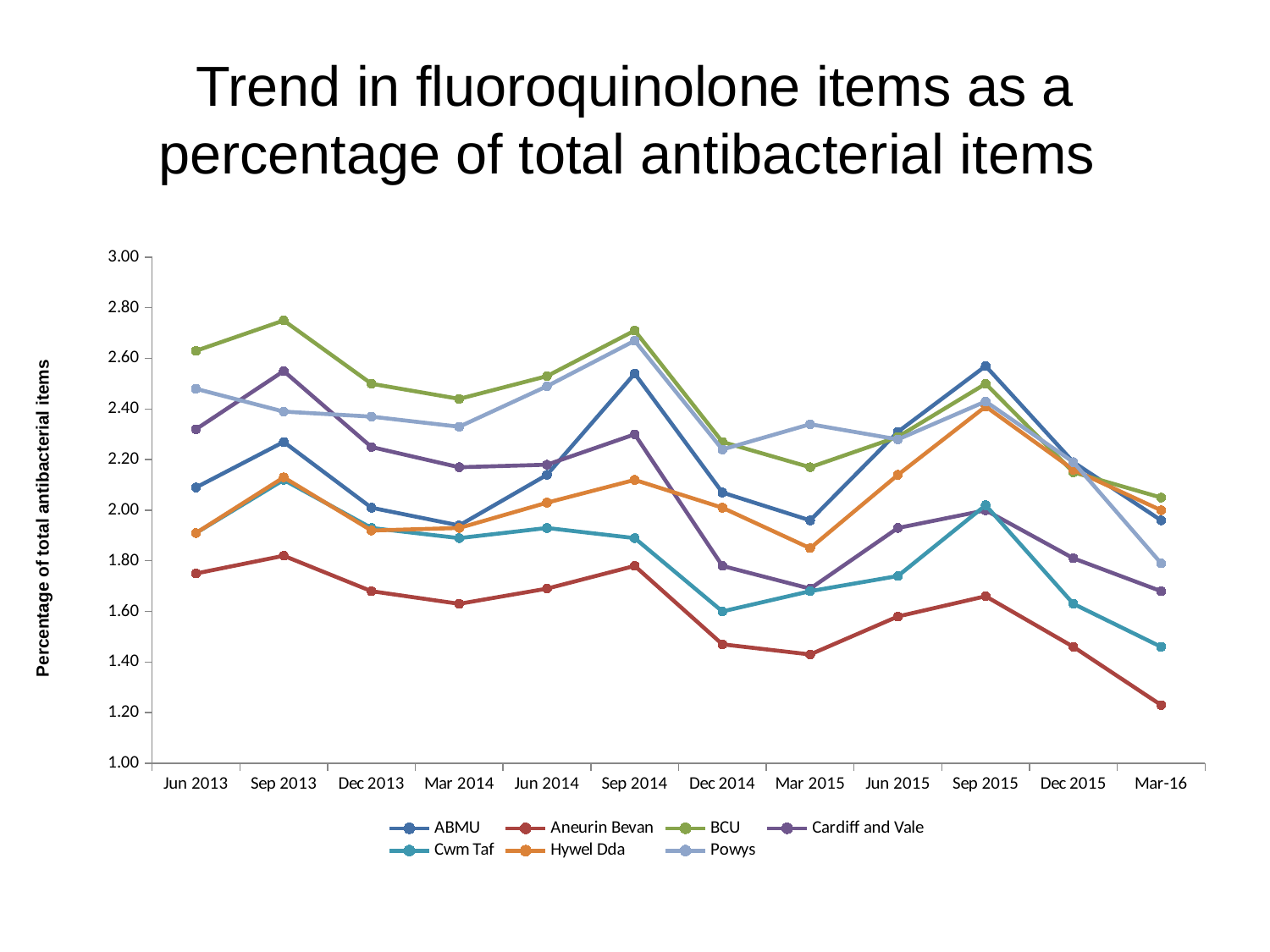
Which series has the lowest value at Mar-16? Aneurin Bevan How many series does the legend list? 7 How many time points are shown along the x axis? 12 Which series has the lowest value at Jun 2013? Aneurin Bevan Does the Aneurin Bevan line rise or fall from Sep 2015 to Mar-16? fall Which series has the highest value at Jun 2013? BCU Is the value for BCU at Sep 2013 greater or less than 2.60? greater At Dec 2014, which is higher: Powys or Cwm Taf? Powys What kind of chart is shown on the slide? line chart Is the value for Aneurin Bevan at Mar-16 greater or less than 1.40? less Is the value for Cwm Taf at Dec 2014 greater or less than 1.80? less What is the label on the y axis? Percentage of total antibacterial items